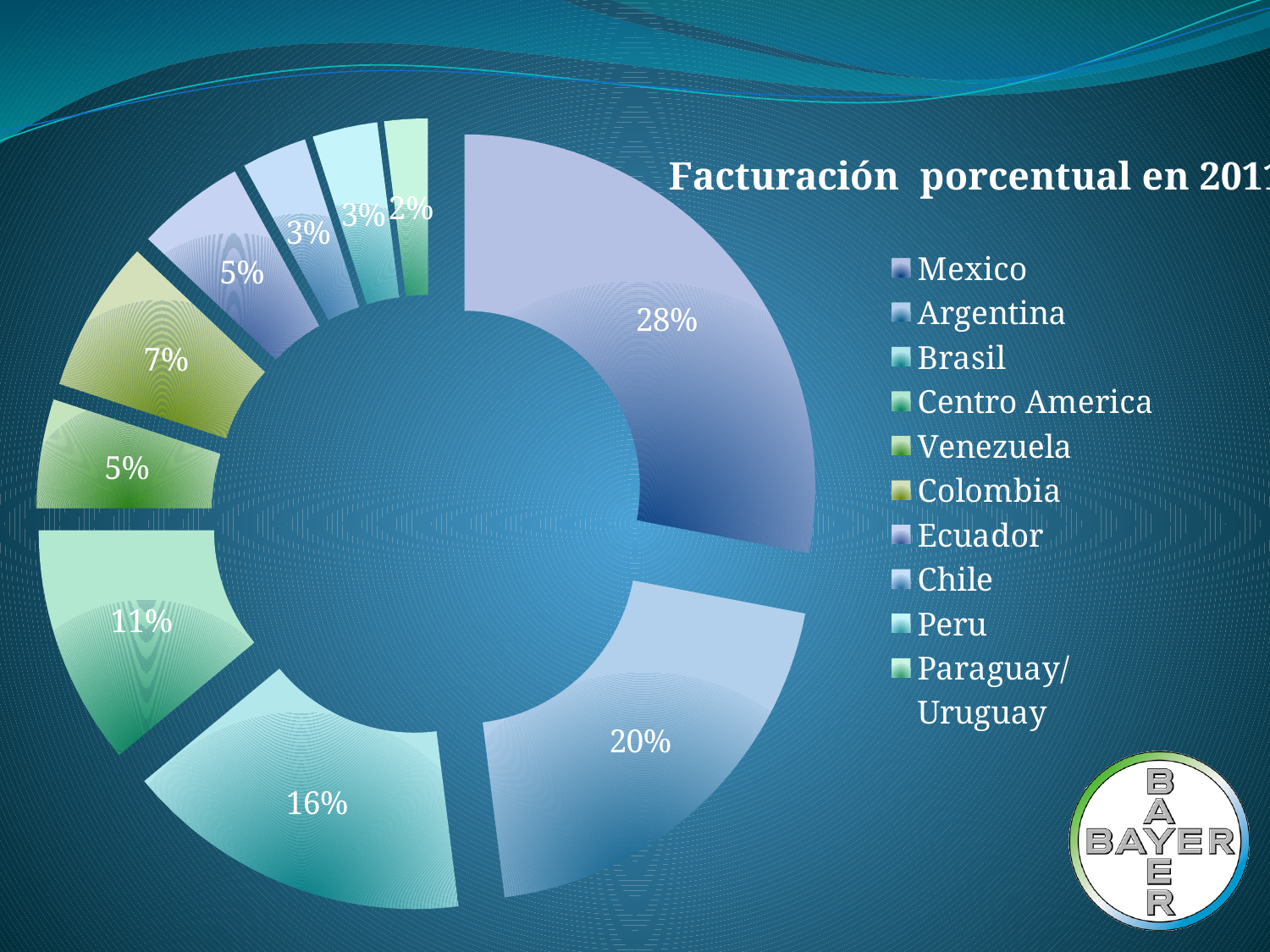
Which has a larger share, Brasil or Centro America? Brasil What is the difference in percentage points between Mexico's share and Argentina's share? 8 What percentage share does Argentina have in the chart? 20% Which category has the smallest share in the chart? Paraguay/Uruguay Which country has the largest share in the chart? Mexico What percentage share does Centro America have in the chart? 11% What is the title of the chart? Facturación porcentual en 2011 What kind of chart is shown on the slide? Doughnut chart What percentage share does Colombia have in the chart? 7% What percentage share does Brasil have in the chart? 16% What percentage share does Mexico have in the chart? 28% How many categories does the legend list? 10